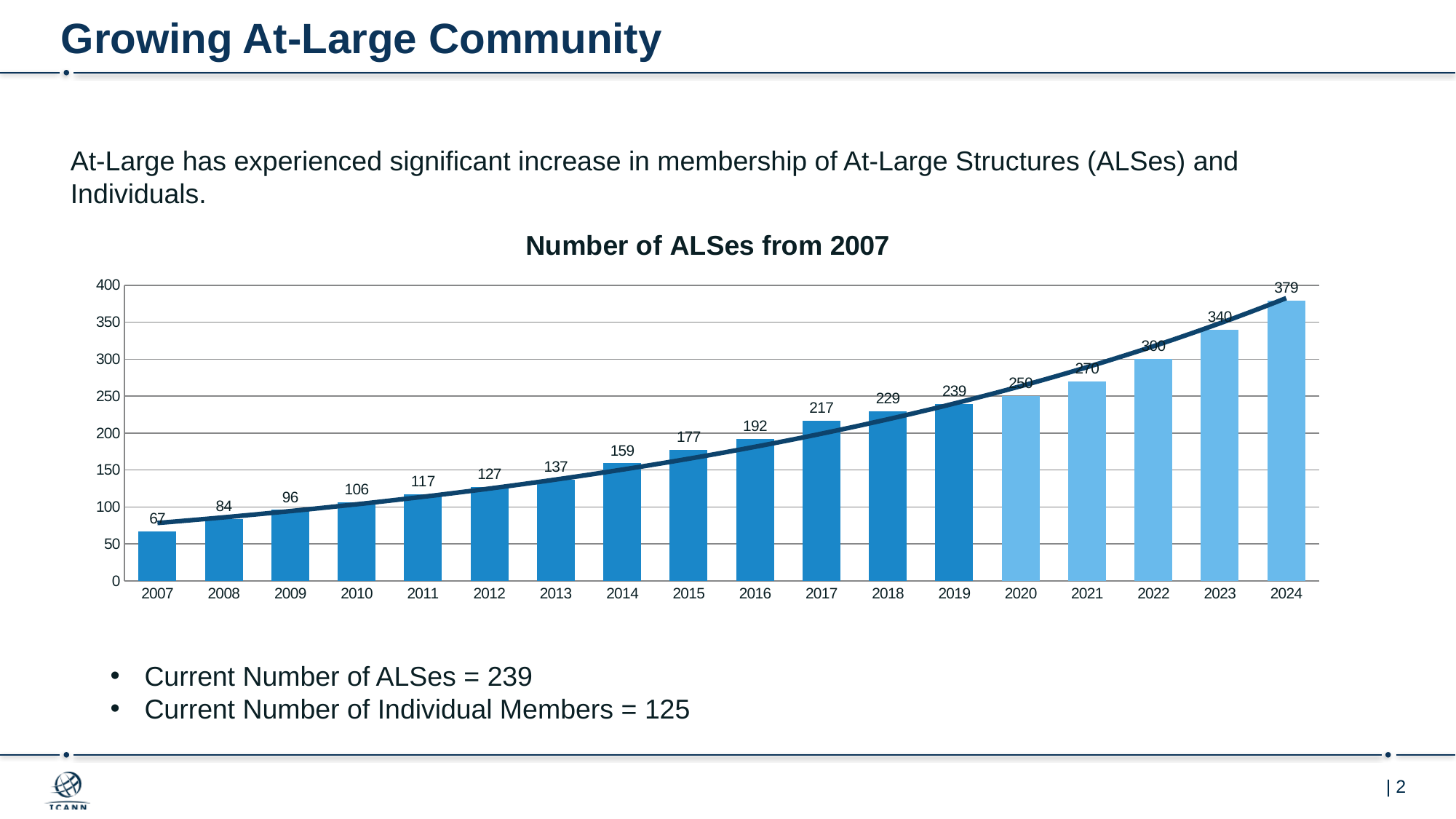
What type of chart is shown on the slide? bar chart What is the number of ALSes in 2014? 159 What is the number of ALSes in 2019? 239 What is the number of ALSes in 2007? 67 What is the difference between the number of ALSes in 2024 and in 2007? 312 Which year has the highest number of ALSes? 2024 Do the values rise or fall from 2007 to 2024? rise Which year has the lowest number of ALSes? 2007 What is the difference between the number of ALSes in 2018 and in 2017? 12 What is the title of the chart? Number of ALSes from 2007 Which year has more ALSes, 2012 or 2016? 2016 How many years are shown on the x axis of the chart? 18